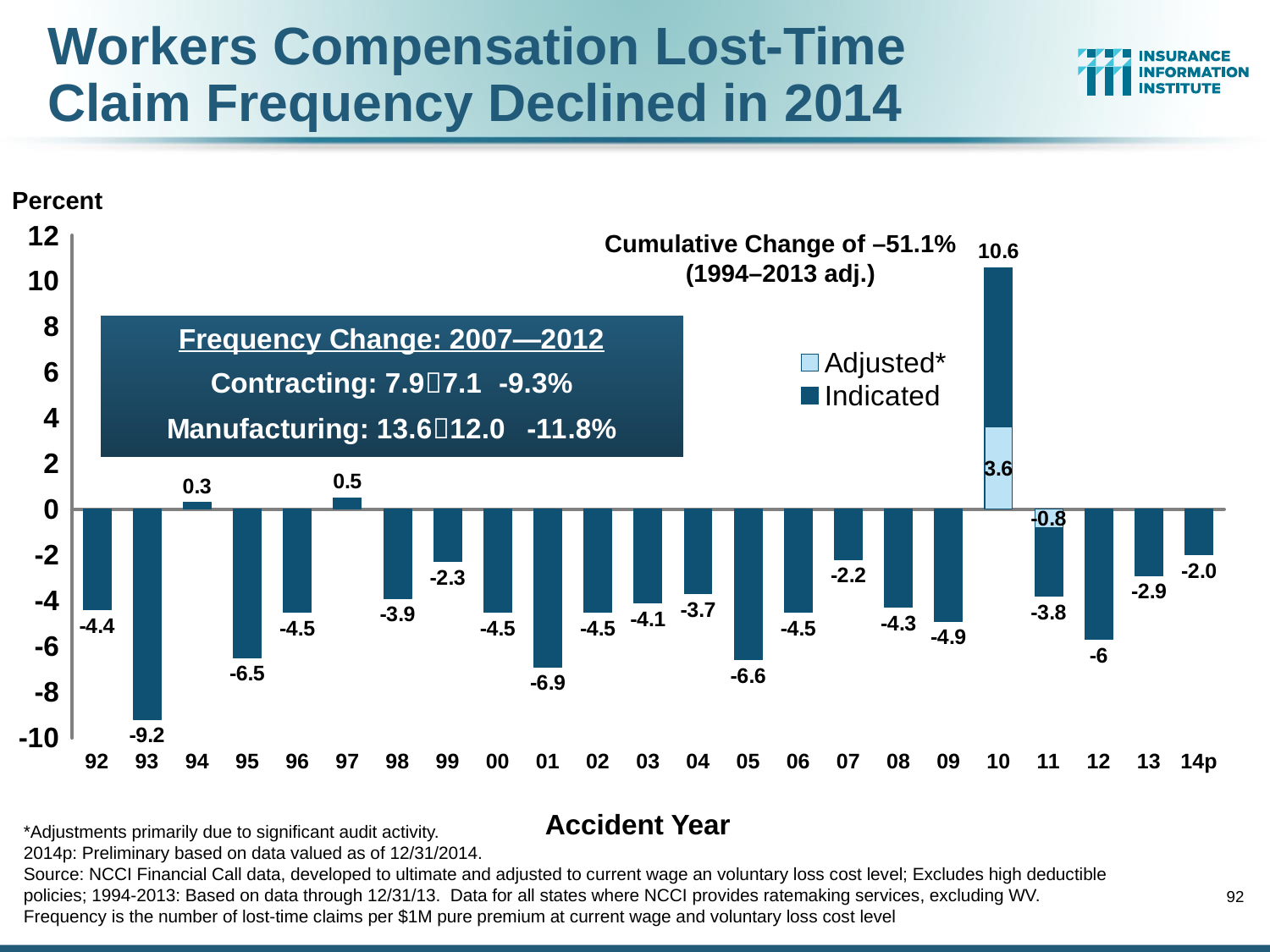
What is the difference between the values for accident years 12 and 13? 3.1 Which accident year has the lowest value on the chart? 93 What is the value for accident year 93? -9.2 Which accident year has the highest value on the chart? 10 What is the value for accident year 14p? -2.0 Which is larger, the value for accident year 01 or the value for accident year 05? 05 How many accident years are shown on the x axis? 23 What kind of chart is shown on the slide? Bar chart What is the Indicated value for accident year 10? 10.6 What is the Adjusted value for accident year 10? 3.6 What cumulative change for 1994–2013 (adj.) is stated on the chart? –51.1% How many series does the legend list? 2